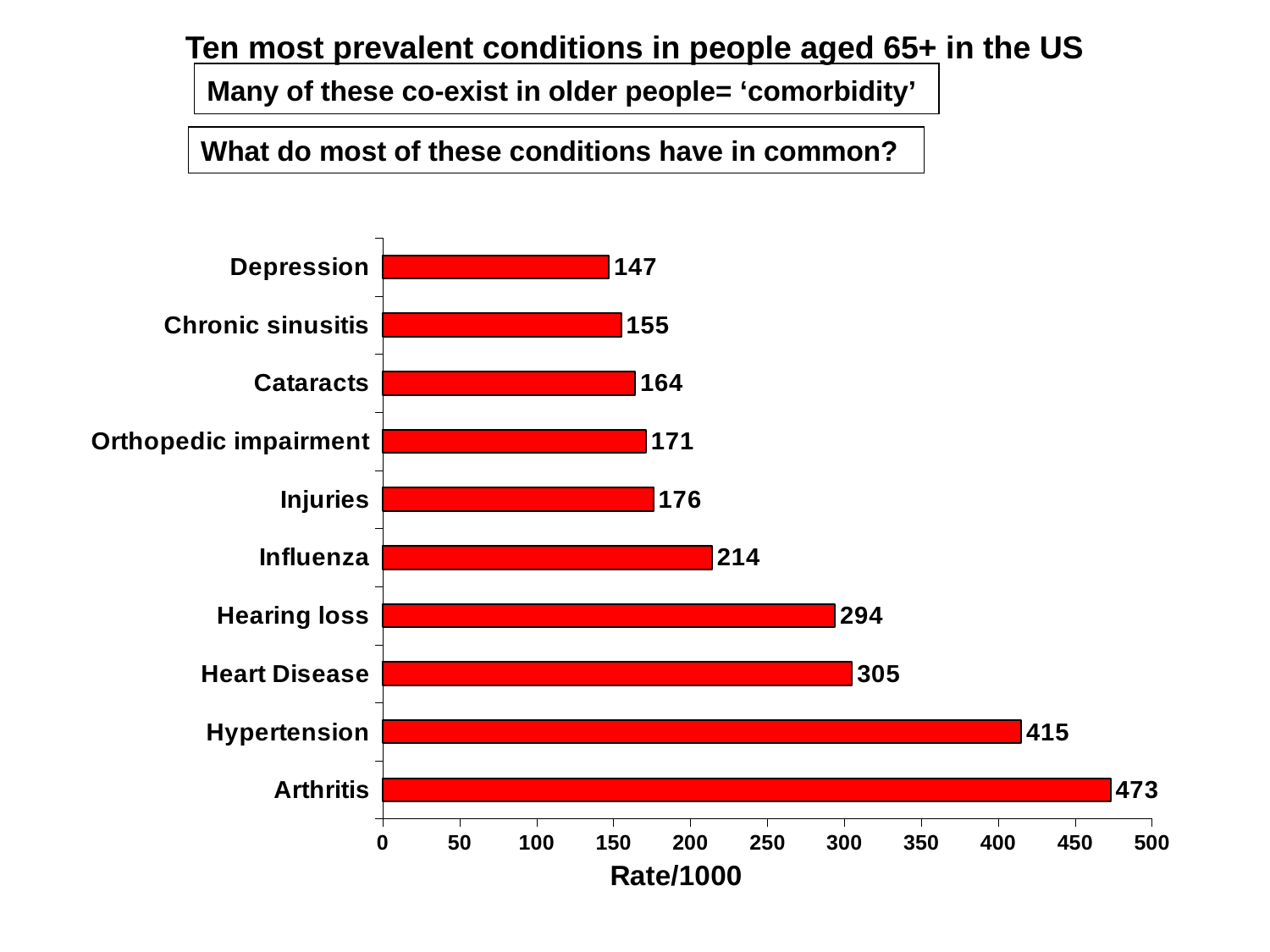
What is the rate per 1000 for Hearing loss? 294 Which condition has the lowest rate per 1000? Depression What is the label on the horizontal axis of the chart? Rate/1000 How many conditions are shown in the chart? 10 What kind of chart is shown on the slide? Bar chart What is the rate per 1000 for Arthritis? 473 Which has a higher rate per 1000, Hearing loss or Influenza? Hearing loss Which condition has the highest rate per 1000? Arthritis Is the value for Hypertension greater or less than 400? greater What is the difference between the rates for Hypertension and Heart Disease? 110 What is the difference between the rates for Influenza and Injuries? 38 What is the rate per 1000 for Cataracts? 164